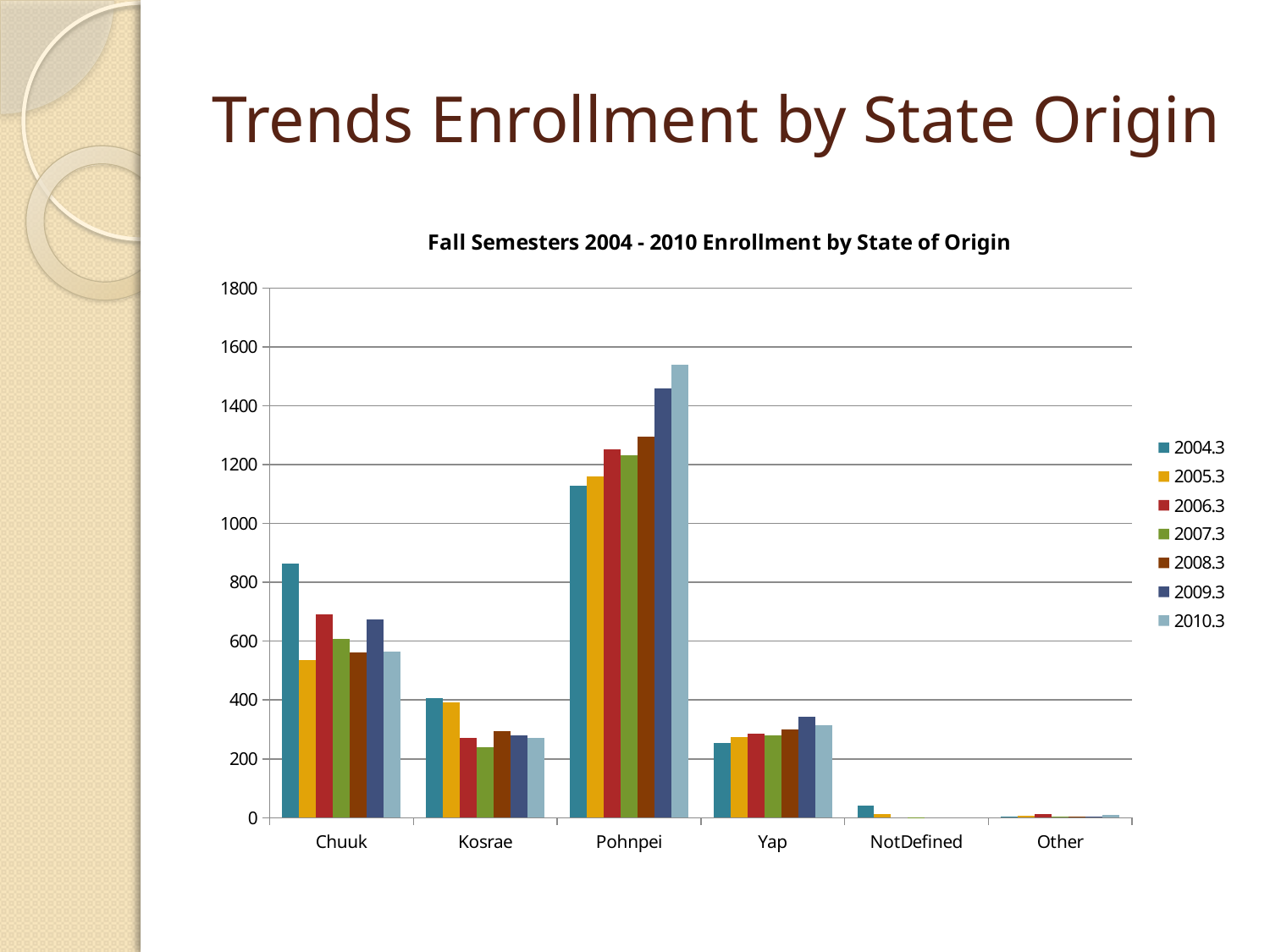
What is the title of the chart? Fall Semesters 2004 - 2010 Enrollment by State of Origin How many state-of-origin categories are shown on the x axis? 6 Which state of origin has the highest enrollment in 2010.3? Pohnpei Is the enrollment for Pohnpei in 2010.3 greater or less than 1400? greater Is the enrollment for Kosrae in 2004.3 greater or less than 600? less For Pohnpei, which is larger, the 2009.3 bar or the 2010.3 bar? 2010.3 Is the enrollment for Chuuk in 2004.3 greater or less than 800? greater Which is larger in 2004.3, the enrollment for Chuuk or for Kosrae? Chuuk What kind of chart is shown on the slide? Bar chart How many series does the legend list? 7 Does enrollment for Pohnpei generally rise or fall from 2004.3 to 2010.3? rise